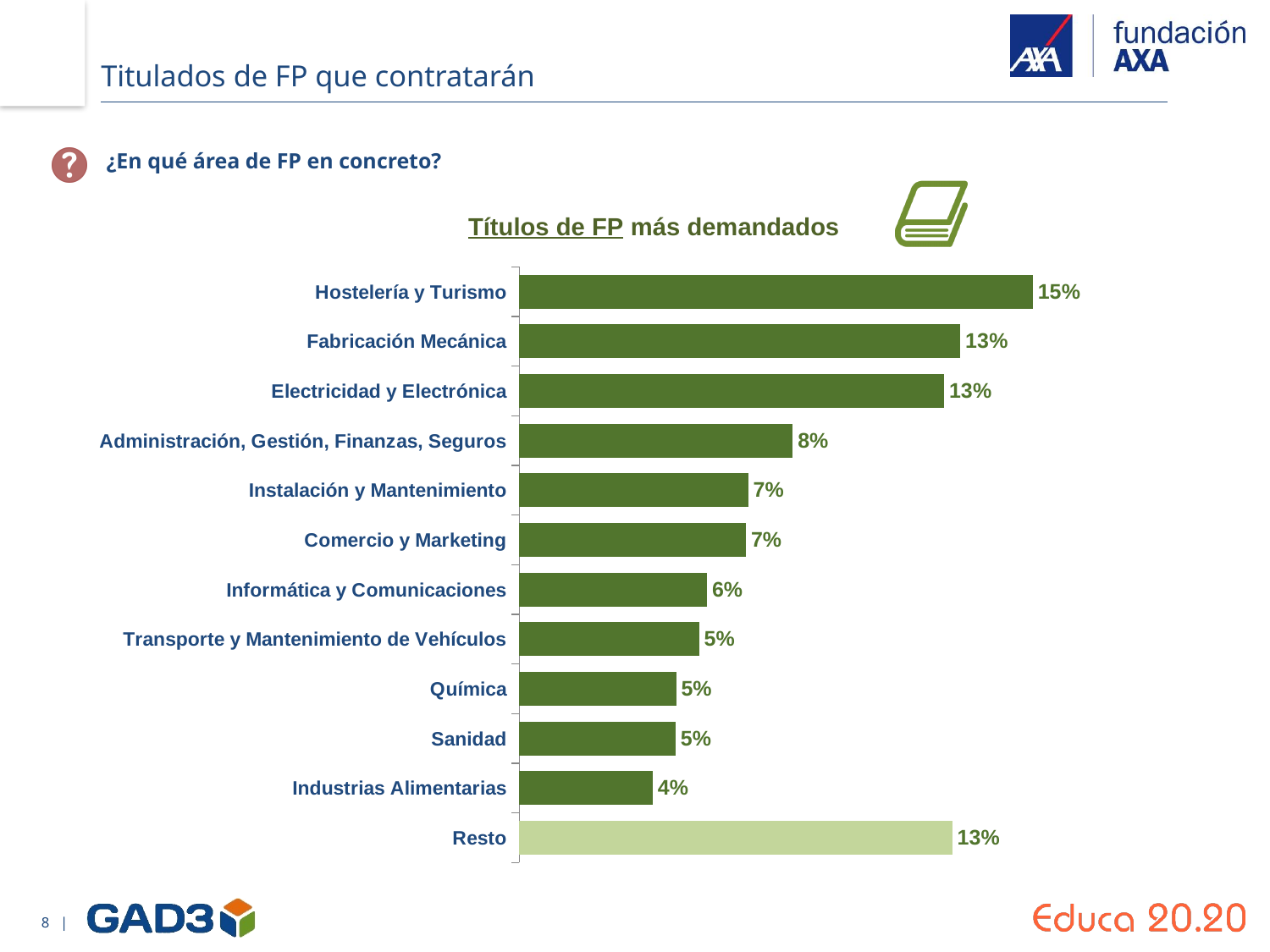
Which bar is drawn in a lighter green than the others? Resto What is the value for Resto? 13% What is the value for Administración, Gestión, Finanzas, Seguros? 8% Which category has the lowest value? Industrias Alimentarias What is the value for Informática y Comunicaciones? 6% How many categories are shown in the chart? 12 Which is larger, the value for Fabricación Mecánica or the value for Instalación y Mantenimiento? Fabricación Mecánica Which category has the highest value? Hostelería y Turismo What is the title of the chart? Títulos de FP más demandados What kind of chart is shown on the slide? Bar chart What is the value for Hostelería y Turismo? 15% What is the difference between the values for Hostelería y Turismo and Administración, Gestión, Finanzas, Seguros? 7 percentage points